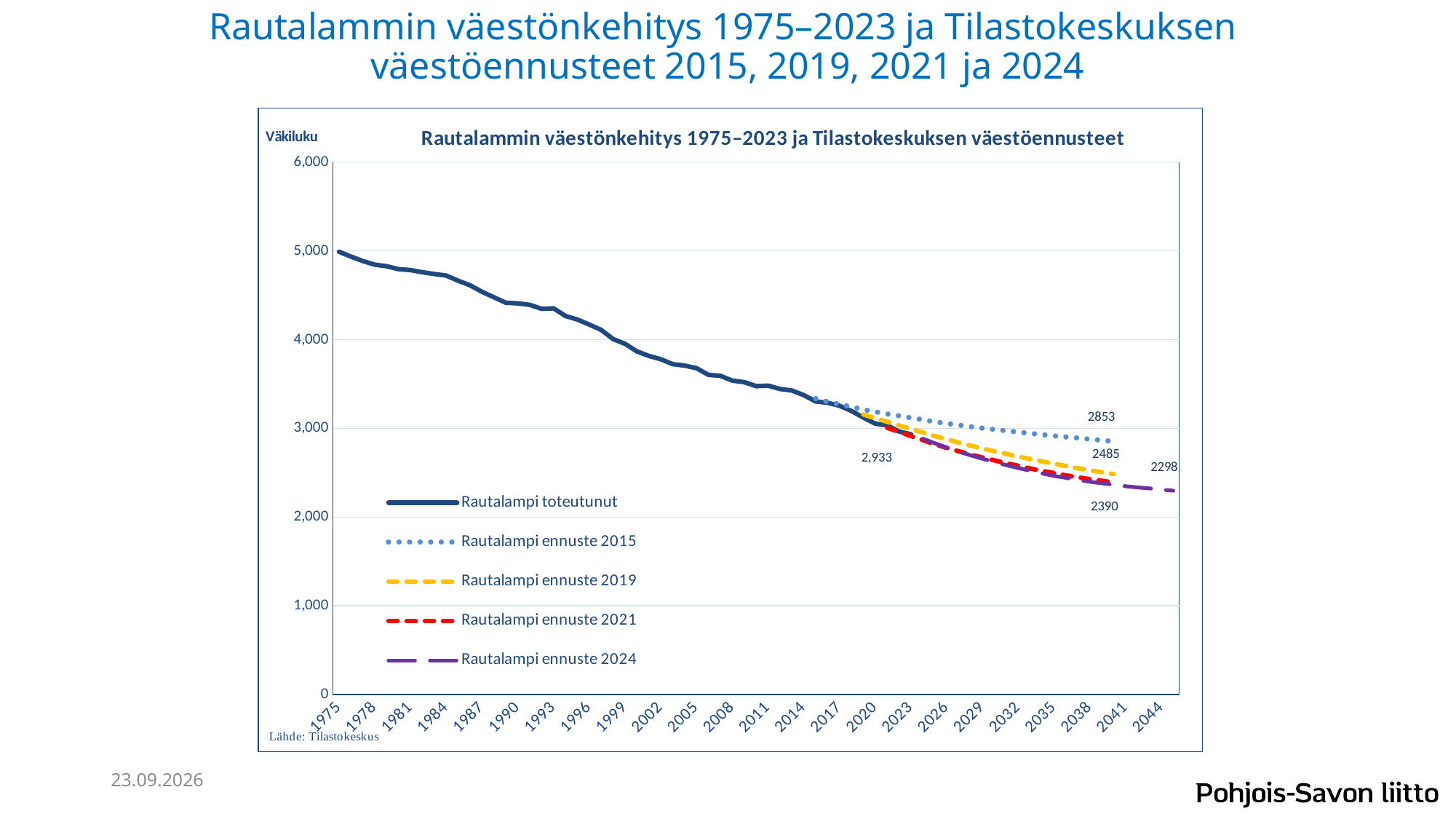
What is the labelled end value of the Rautalampi ennuste 2024 series? 2298 Which forecast series ends at the highest labelled value? Rautalampi ennuste 2015 Is the value of Rautalampi toteutunut in 1975 greater or less than 4,000? greater What is the labelled end value of the Rautalampi ennuste 2015 series? 2853 What is the labelled value at the end of the Rautalampi toteutunut series? 2,933 Does the Rautalampi toteutunut series rise or fall from 1975 to 2023? fall What is the labelled end value of the Rautalampi ennuste 2019 series? 2485 What is the difference between the labelled end values of the ennuste 2015 series (2853) and the ennuste 2024 series (2298)? 555 What kind of chart is shown on the slide? line chart Which ends higher, the ennuste 2019 series or the ennuste 2021 series? Rautalampi ennuste 2019 How many series does the legend list? 5 What is the labelled end value of the Rautalampi ennuste 2021 series? 2390